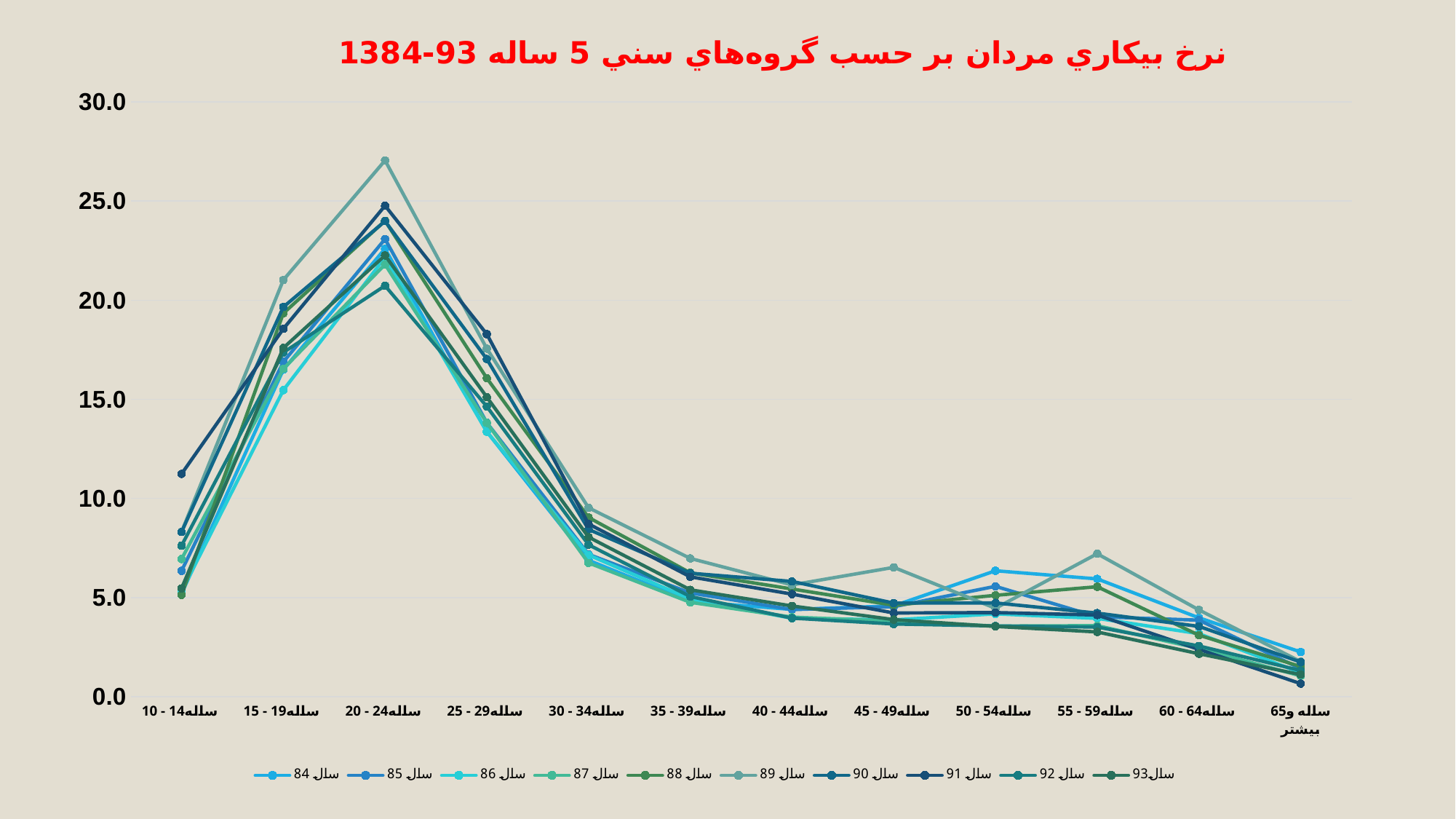
Which series has the highest value at the 10 - 14 ساله age group? سال 91 How many age-group categories are shown on the x axis? 12 Which series has the highest value at the 20 - 24 ساله age group? سال 89 At the 20 - 24 ساله age group, which is larger: the value for سال 89 or the value for سال 86? سال 89 For which age group does the سال 89 series reach its highest value? 20 - 24 ساله How many series does the legend list? 10 Is the value for سال 84 at 65 ساله و بيشتر greater or less than 5? less What kind of chart is shown on the slide? line chart Is the value for سال 89 at 20 - 24 ساله greater or less than 25? greater Do the values for سال 89 rise or fall from the 20 - 24 ساله group to the 65 ساله و بيشتر group? fall Is the value for سال 91 at 10 - 14 ساله greater or less than 10? greater What is the title of the chart? نرخ بيكاري مردان بر حسب گروه‌هاي سني 5 ساله 1384-93